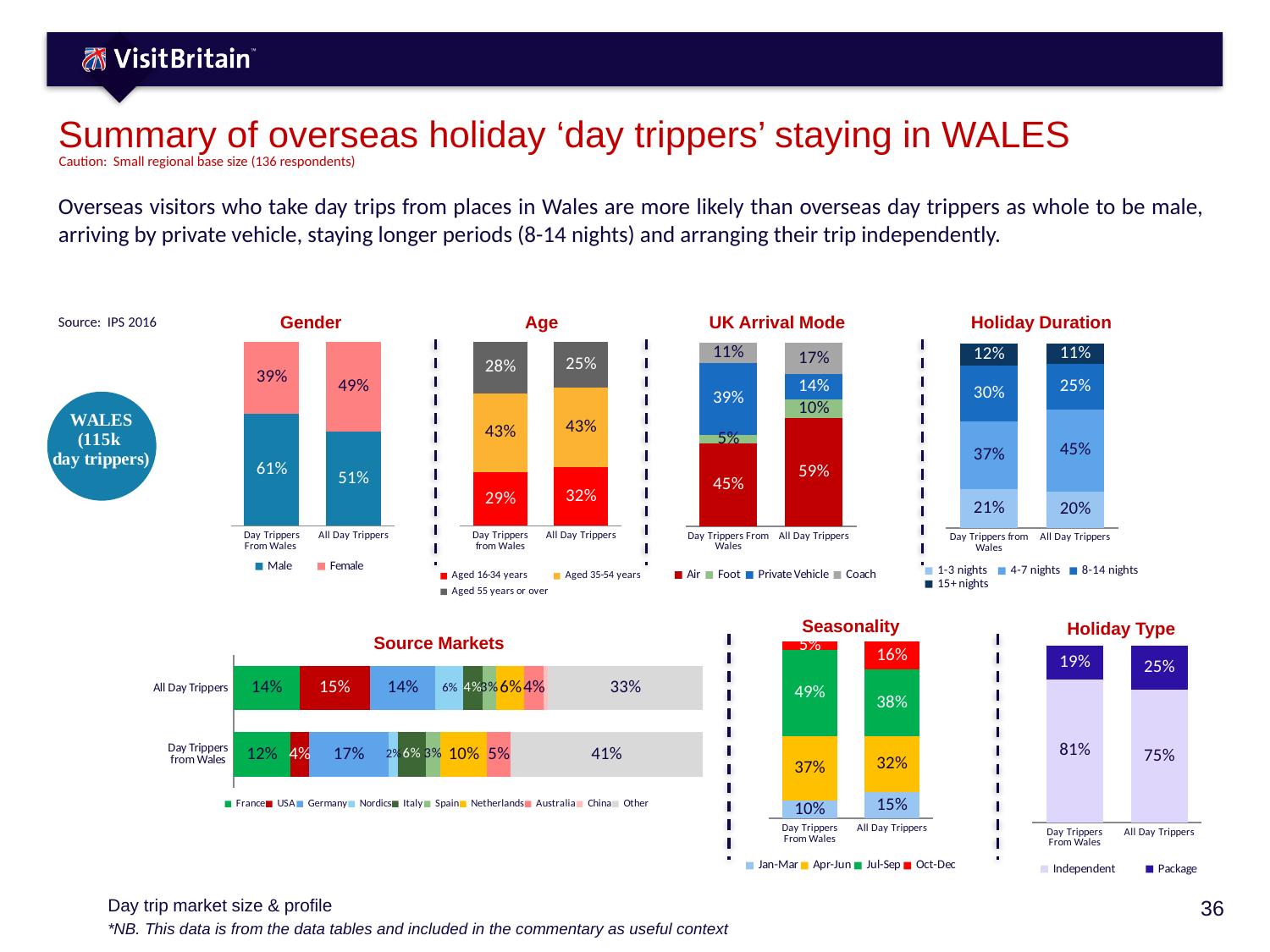
In the UK Arrival Mode chart, what percentage of Day Trippers From Wales arrive by private vehicle? 39% In the Gender chart, what percentage of Day Trippers From Wales are male? 61% In the Age chart, what percentage of All Day Trippers are aged 16-34 years? 32% In the Holiday Type chart, what percentage of All Day Trippers travel on a package? 25% In the Source Markets chart, what percentage of Day Trippers from Wales come from Germany? 17% How many series does the legend of the Seasonality chart list? 4 In the Gender chart, what is the difference between the female share for All Day Trippers and for Day Trippers From Wales? 10 percentage points In the Age chart, which age group is the largest for Day Trippers from Wales? Aged 35-54 years In the Holiday Duration chart, which group has the larger share staying 8-14 nights, Day Trippers from Wales or All Day Trippers? Day Trippers from Wales In the Seasonality chart, what percentage of Day Trippers From Wales travel in Jul-Sep? 49% In the Holiday Duration chart, what percentage of All Day Trippers stay 4-7 nights? 45% In the UK Arrival Mode chart, which arrival mode is the smallest for Day Trippers From Wales? Foot